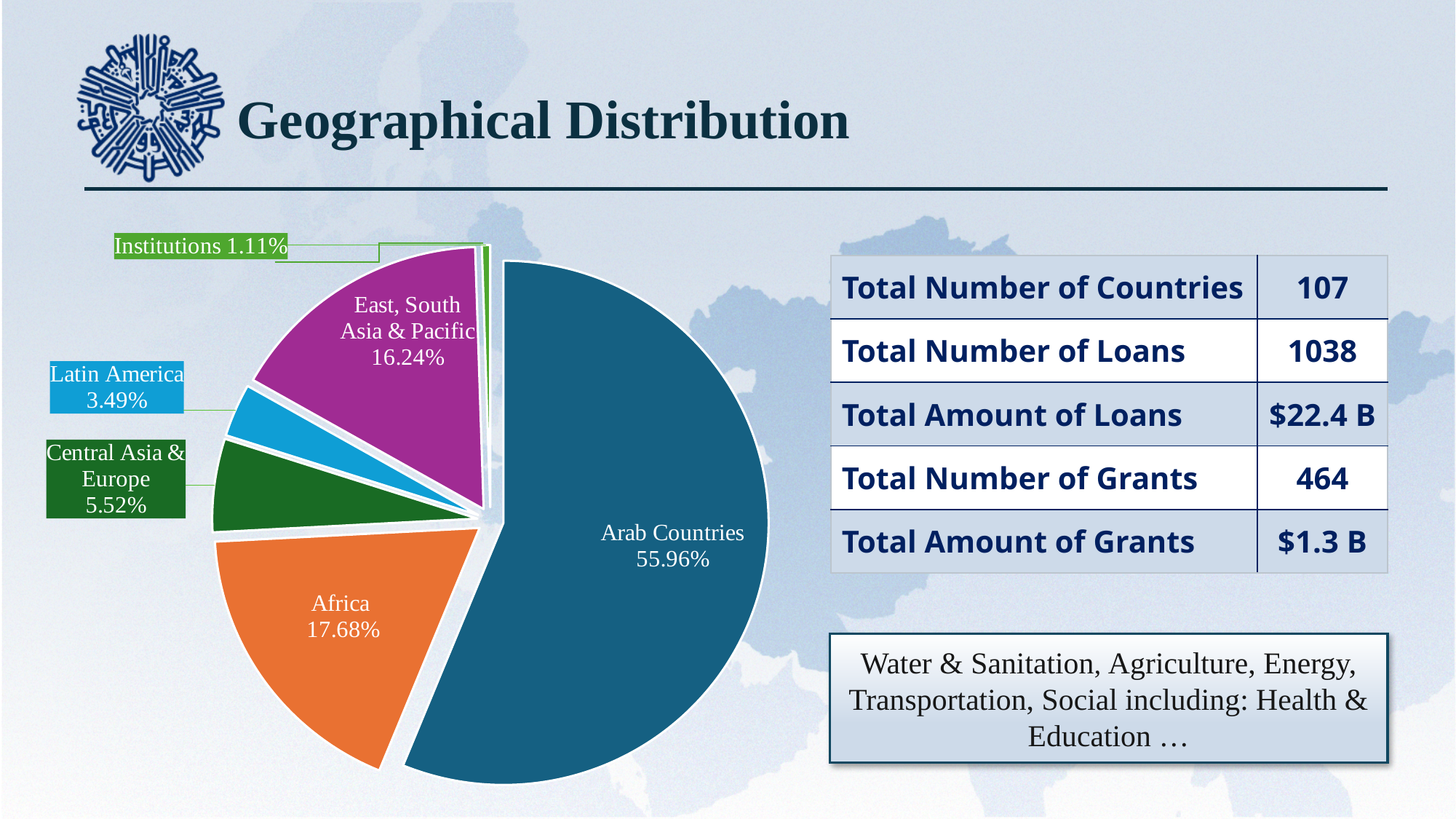
What share of the pie chart does Arab Countries represent? 55.96% Which slice of the pie chart is the largest? Arab Countries How many slices does the pie chart have? 6 What share of the pie chart does Africa represent? 17.68% What share of the pie chart does Institutions represent? 1.11% Which slice is larger, Central Asia & Europe or Latin America? Central Asia & Europe What is the difference in percentage points between the Africa slice and the East, South Asia & Pacific slice? 1.44 Which slice of the pie chart is the smallest? Institutions What kind of chart is shown on the slide? pie chart What share of the pie chart does Latin America represent? 3.49% What share of the pie chart does East, South Asia & Pacific represent? 16.24% What share of the pie chart does Central Asia & Europe represent? 5.52%